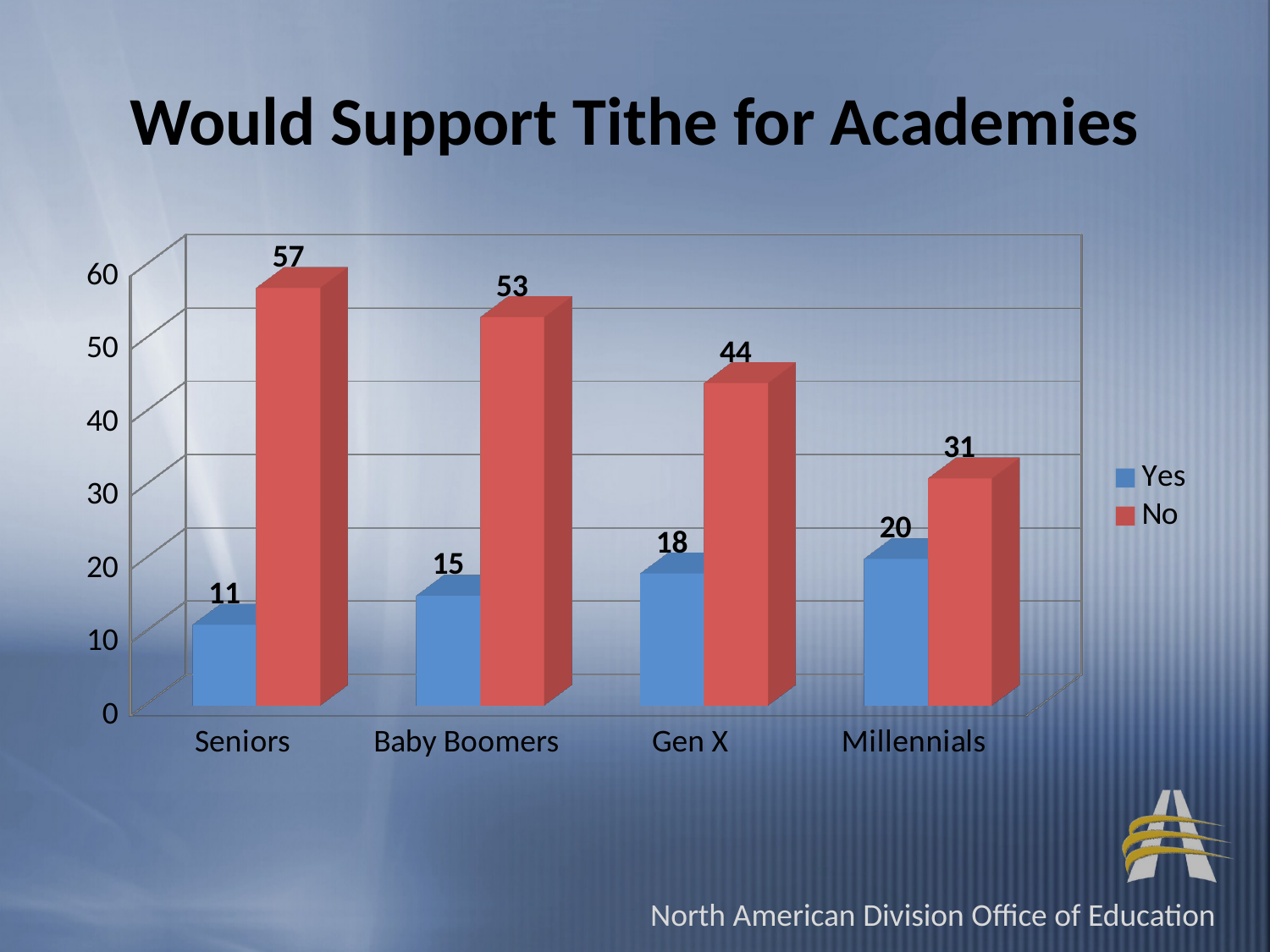
Do the "No" values rise or fall from Seniors to Millennials? Fall What is the "Yes" value for Gen X? 18 What kind of chart is shown on the slide? Bar chart What is the "Yes" value for Millennials? 20 Which is larger: the "Yes" value for Millennials or the "Yes" value for Baby Boomers? Millennials What is the title of the chart? Would Support Tithe for Academies How many series does the legend list? 2 Which category has the lowest "Yes" value? Seniors How many categories are shown on the x axis? 4 Which category has the highest "No" value? Seniors What is the difference between the "No" and "Yes" values for Baby Boomers? 38 What is the "No" value for Seniors? 57